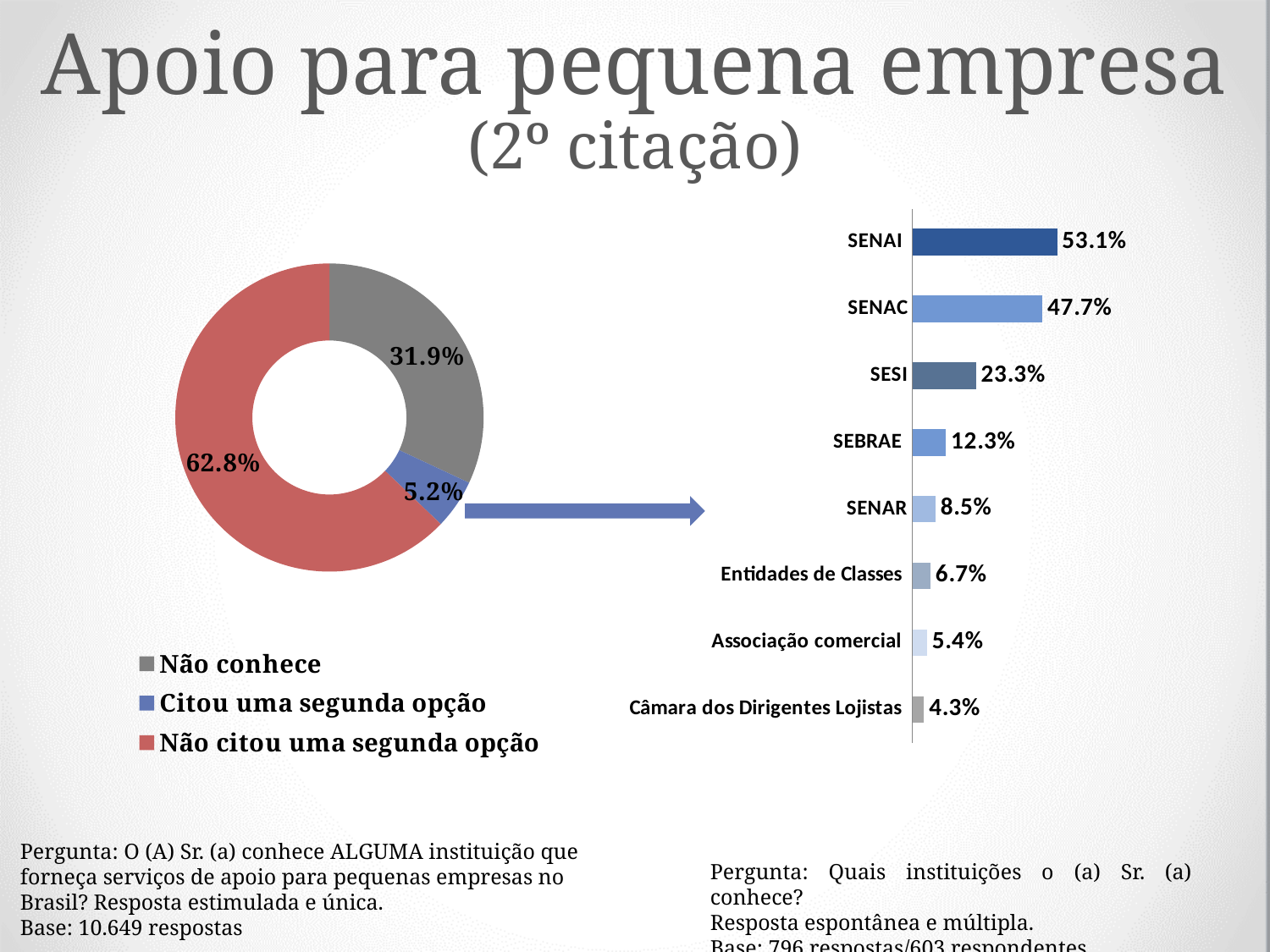
In the donut chart on the left, what share is labelled for 'Não conhece'? 31.9% In the bar chart on the right, what is the value for SEBRAE? 12.3% In the donut chart on the left, what is the difference between the shares for 'Não citou uma segunda opção' and 'Não conhece'? 30.9% In the bar chart on the right, which institution has the highest value? SENAI In the donut chart on the left, how many categories does the legend list? 3 In the bar chart on the right, how many institutions are shown? 8 In the donut chart on the left, which category has the largest share? Não citou uma segunda opção In the bar chart on the right, which institution has the lowest value? Câmara dos Dirigentes Lojistas In the bar chart on the right, what is the value for SENAC? 47.7% What type of chart is shown on the right side of the slide? Bar chart In the bar chart on the right, what is the difference between the values for SENAI and SESI? 29.8% In the donut chart on the left, what share is labelled for 'Citou uma segunda opção'? 5.2%